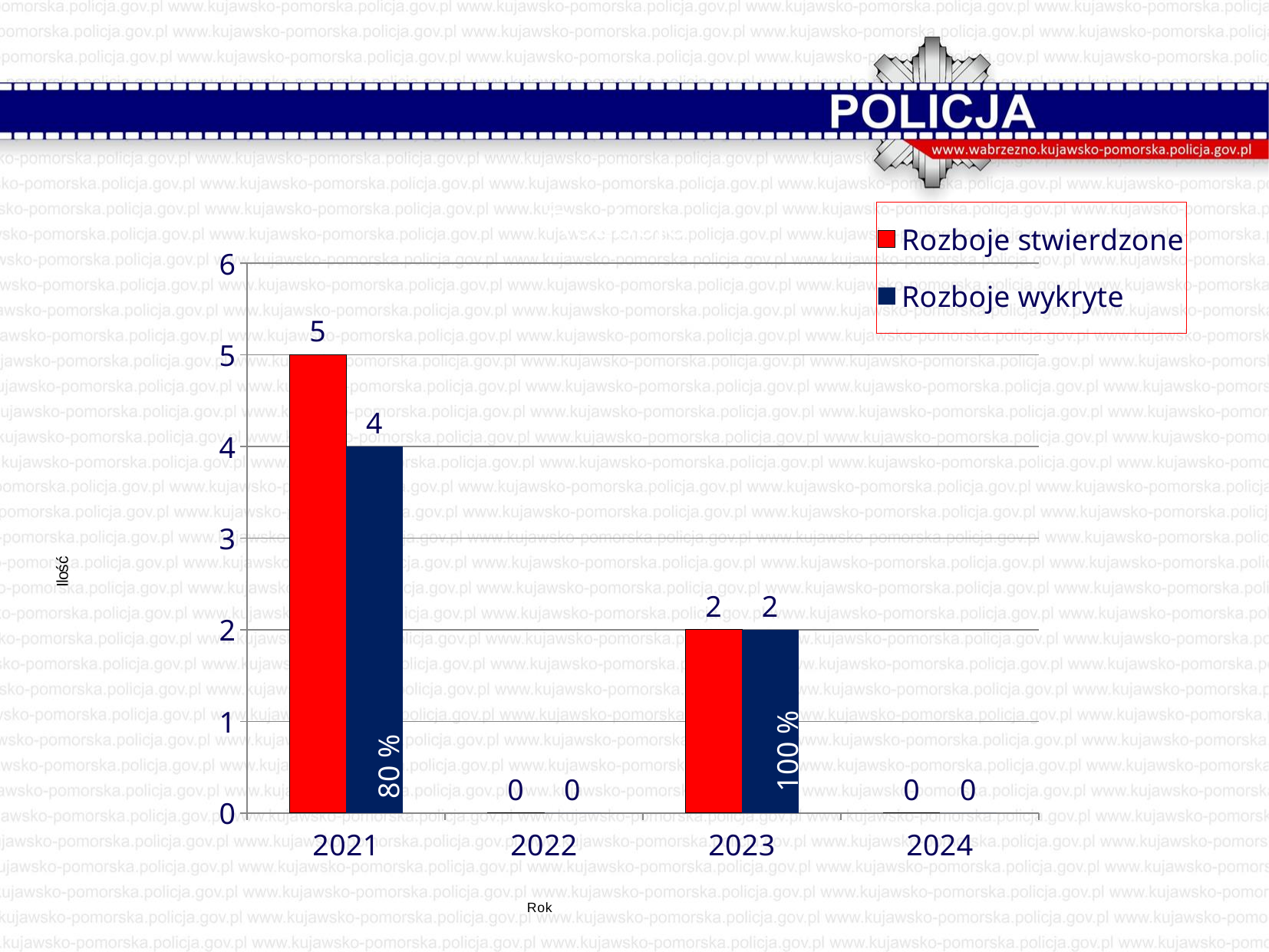
How many years are shown on the x axis? 4 Which year has the highest value for Rozboje stwierdzone? 2021 What is the label of the y axis? Ilość What percentage label is shown on the 2023 bars? 100 % What is the value of Rozboje wykryte for 2021? 4 Which is larger in 2021, Rozboje stwierdzone or Rozboje wykryte? Rozboje stwierdzone What is the value of Rozboje stwierdzone for 2023? 2 What is the value of Rozboje wykryte for 2022? 0 What is the difference between Rozboje stwierdzone and Rozboje wykryte in 2021? 1 What is the value of Rozboje stwierdzone for 2021? 5 What kind of chart is shown on the slide? bar chart How many series does the legend list? 2